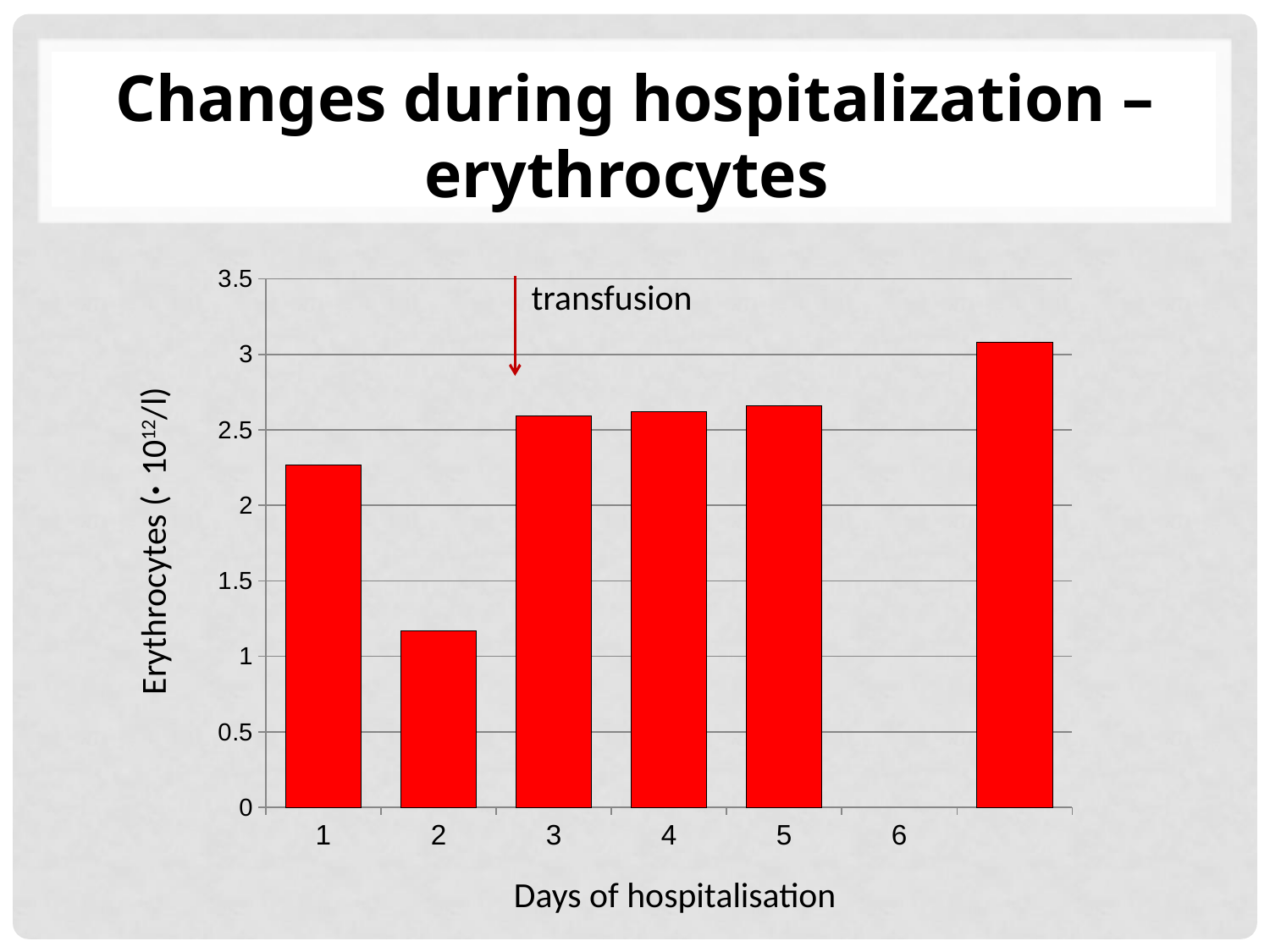
How many bars are plotted in the chart? 6 What event does the arrow annotation on the chart mark? transfusion Is the erythrocyte value for day 2 greater or less than 1.5? less What is the title of the x axis? Days of hospitalisation Is the erythrocyte value for day 1 greater or less than 2? greater Which has the higher erythrocyte value, day 1 or day 2? day 1 What kind of chart is shown on the slide? bar chart Is the erythrocyte value for day 1 greater or less than 2.5? less Which day of hospitalisation has the lowest erythrocyte value? 2 Which has the higher erythrocyte value, day 2 or day 5? day 5